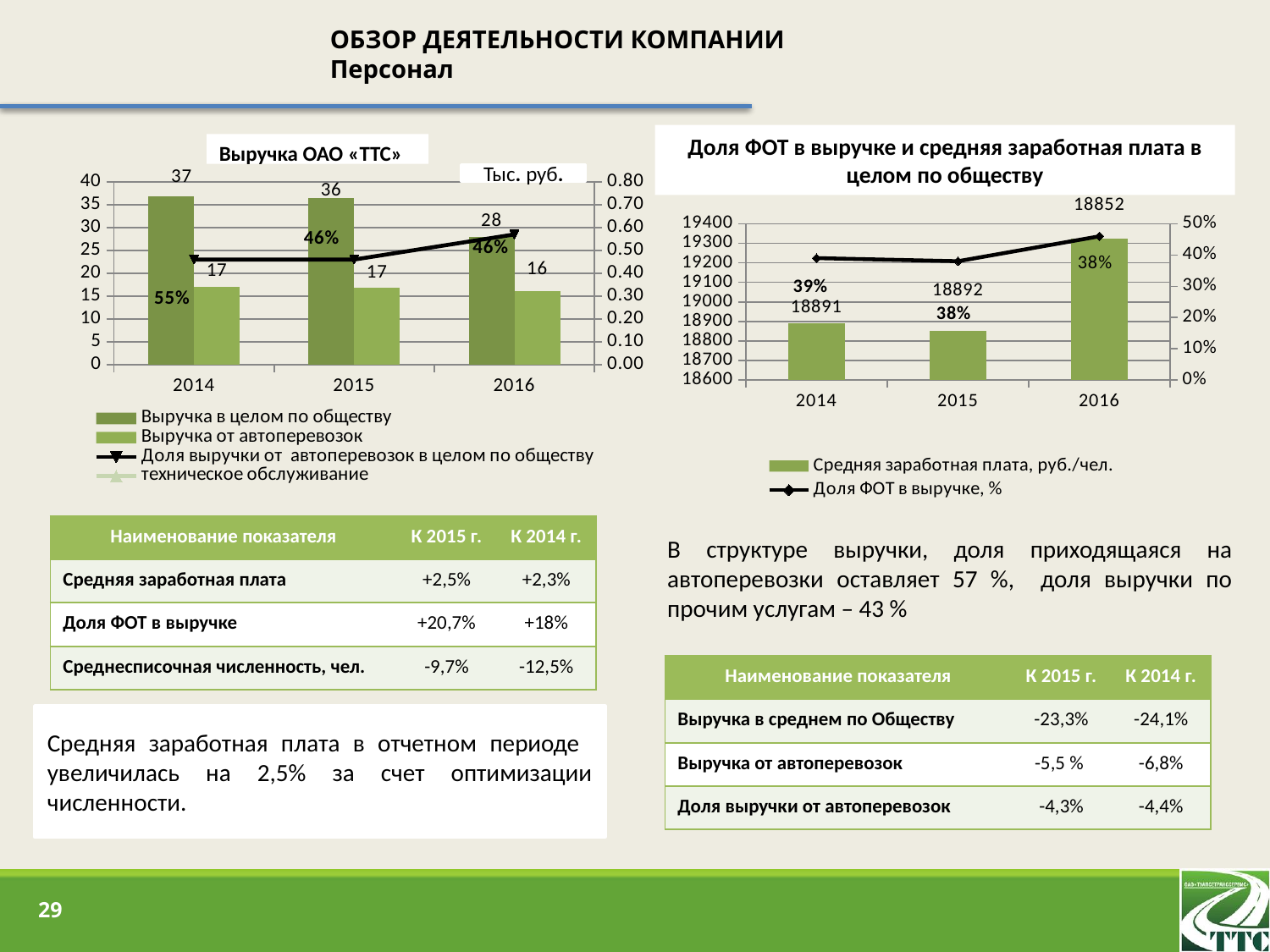
In the chart «Выручка ОАО «ТТС»», which is larger in 2015: «Выручка в целом по обществу» or «Выручка от автоперевозок»? Выручка в целом по обществу In the chart «Выручка ОАО «ТТС»», what is the value of «Выручка от автоперевозок» for 2016? 16 How many years are shown on the x axis of the chart «Доля ФОТ в выручке и средняя заработная плата в целом по обществу»? 3 In the chart «Доля ФОТ в выручке и средняя заработная плата в целом по обществу», what is the average salary (Средняя заработная плата) for 2016? 18852 In the chart «Выручка ОАО «ТТС»», which year has the highest «Выручка в целом по обществу»? 2014 In the chart «Выручка ОАО «ТТС»», what is the «Доля выручки от автоперевозок в целом по обществу» for 2014? 55% In the chart «Выручка ОАО «ТТС»», by how much did «Выручка в целом по обществу» decrease from 2014 to 2016? 9 How many series does the legend of the chart «Доля ФОТ в выручке и средняя заработная плата в целом по обществу» list? 2 In the chart «Доля ФОТ в выручке и средняя заработная плата в целом по обществу», what is «Доля ФОТ в выручке» for 2014? 39% In the chart «Выручка ОАО «ТТС»», does «Выручка в целом по обществу» rise or fall from 2014 to 2016? fall In the chart «Доля ФОТ в выручке и средняя заработная плата в целом по обществу», which year has the lowest average salary? 2015 In the chart «Выручка ОАО «ТТС»», what is the value of «Выручка в целом по обществу» for 2014? 37